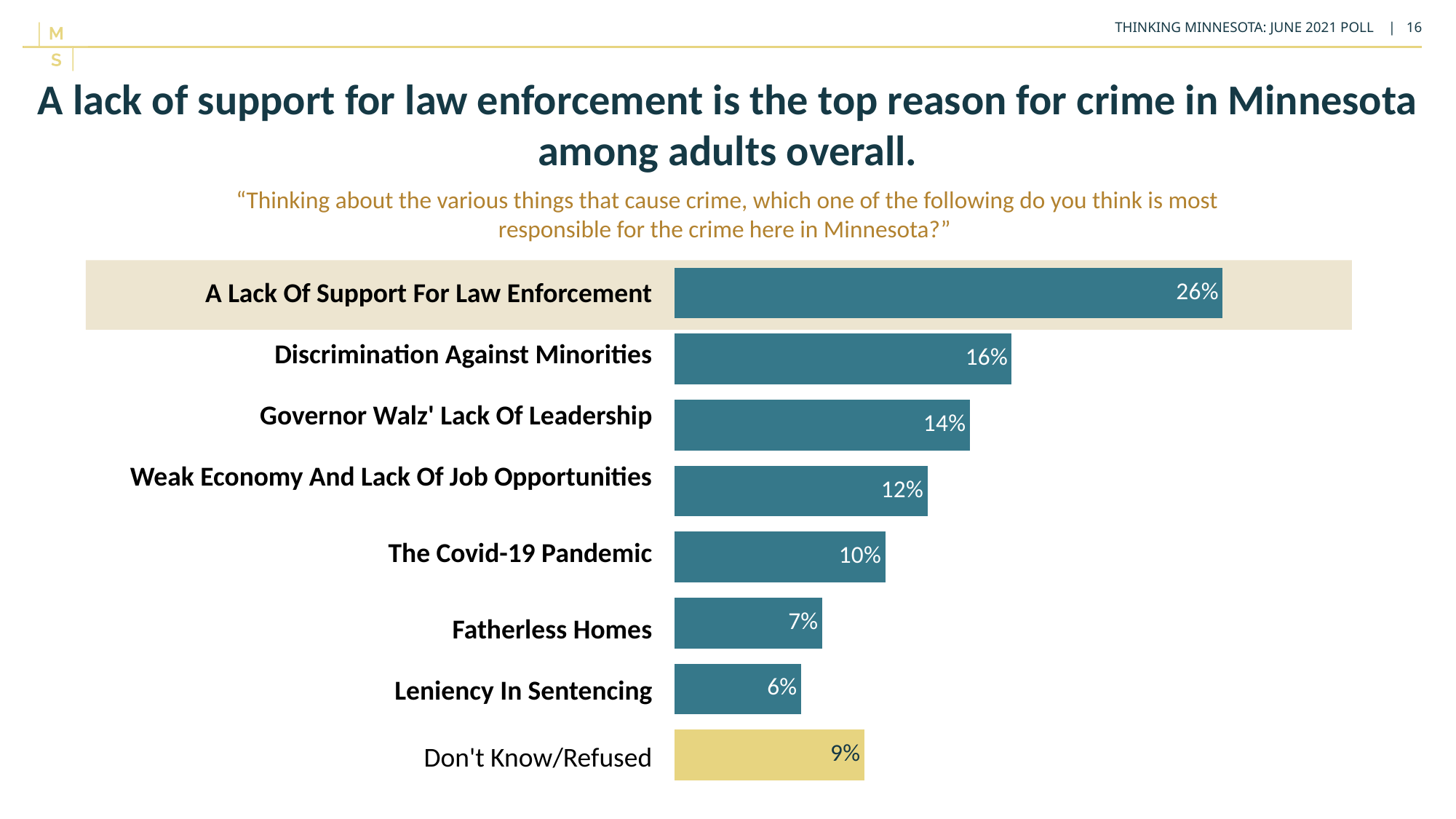
What is the difference between the values for A Lack Of Support For Law Enforcement and Discrimination Against Minorities? 10% Which is larger, the value for Weak Economy And Lack Of Job Opportunities or the value for Don't Know/Refused? Weak Economy And Lack Of Job Opportunities What is the value for Don't Know/Refused? 9% What percentage of adults chose A Lack Of Support For Law Enforcement as the top reason for crime? 26% What is the difference between Governor Walz' Lack Of Leadership and Fatherless Homes? 7% What kind of chart is shown on the slide? Bar chart Which category has the highest value on the chart? A Lack Of Support For Law Enforcement Which category has the lowest value on the chart? Leniency In Sentencing What is the value shown for Discrimination Against Minorities? 16% What percentage is shown for The Covid-19 Pandemic? 10% Which bar is shown in a different colour (yellow) from the others? Don't Know/Refused How many categories are shown on the chart? 8